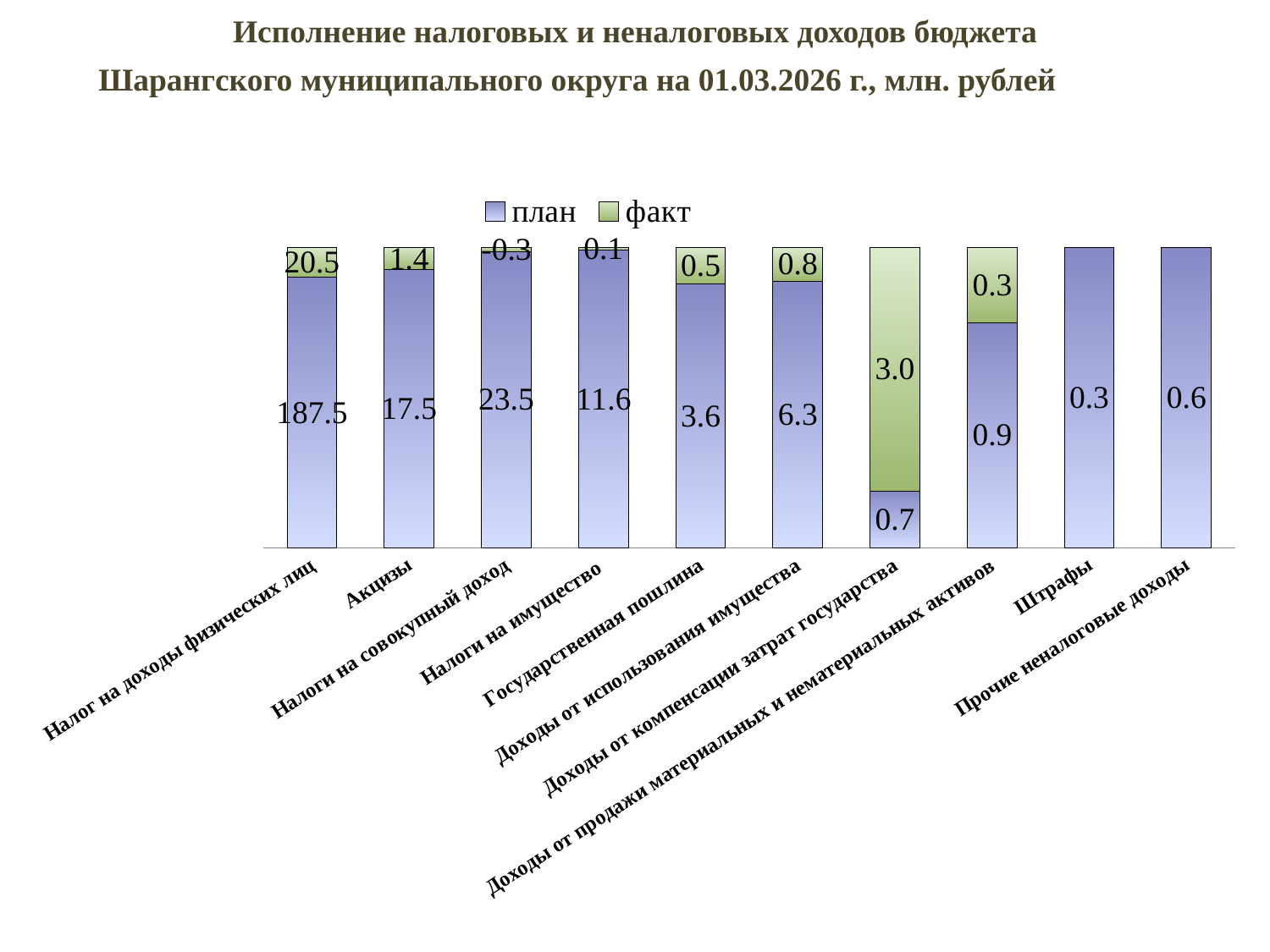
Which category has the highest план value? Налог на доходы физических лиц What is the факт value for Налог на доходы физических лиц? 20.5 Which series is shown in green according to the legend? факт Which category has the lowest план value? Штрафы What is the факт value for Доходы от компенсации затрат государства? 3.0 What is the difference between the план and факт values for Акцизы? 16.1 How many series does the legend list? 2 What is the план value for Акцизы? 17.5 What is the план value for Государственная пошлина? 3.6 Which is larger for Доходы от компенсации затрат государства: the план value or the факт value? факт What kind of chart is shown on the slide? Stacked bar chart How many categories are shown on the x axis? 10